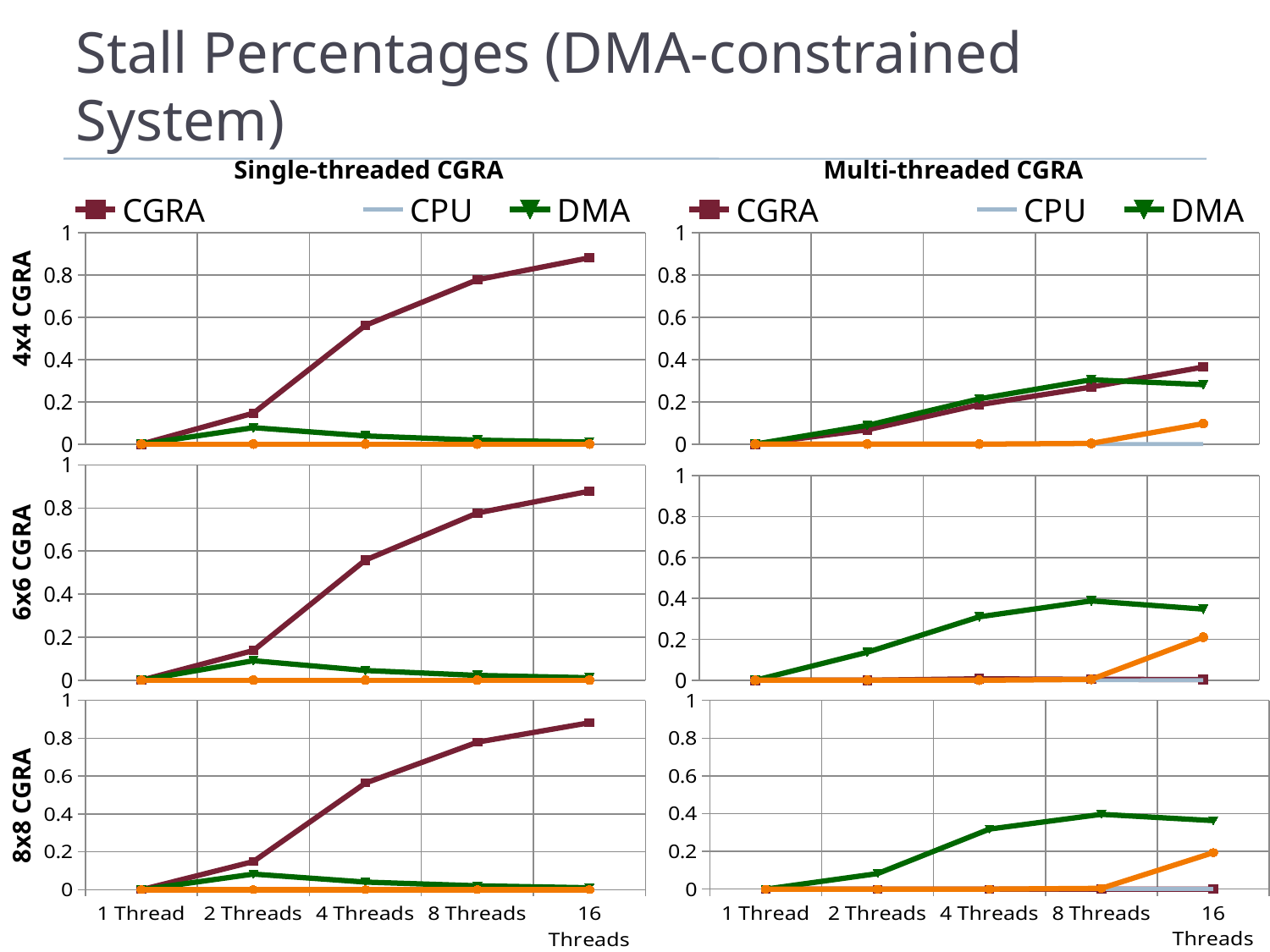
In the Multi-threaded CGRA 4x4 CGRA chart, which is larger at 16 Threads, the CGRA value or the DMA value? CGRA In the Multi-threaded CGRA 8x8 CGRA chart, is the CGRA value at 16 Threads greater or less than 0.2? less In the Single-threaded CGRA 8x8 CGRA chart, does the CGRA series rise or fall as the number of threads increases? rise In the Single-threaded CGRA 6x6 CGRA chart, which is larger at 2 Threads, the CGRA value or the DMA value? CGRA How many series does the legend above the Multi-threaded CGRA charts list? 3 What kind of chart is the Single-threaded CGRA 4x4 CGRA chart? line chart In the Single-threaded CGRA 4x4 CGRA chart, is the CGRA value at 4 Threads greater or less than 0.4? greater In the Multi-threaded CGRA 6x6 CGRA chart, is the DMA value at 8 Threads greater or less than 0.2? greater How many thread-count categories are shown on the x axis of the Single-threaded CGRA 8x8 CGRA chart? 5 What is the title of the slide containing these charts? Stall Percentages (DMA-constrained System) In the Multi-threaded CGRA 4x4 CGRA chart, does the CGRA series rise or fall from 1 Thread to 16 Threads? rise